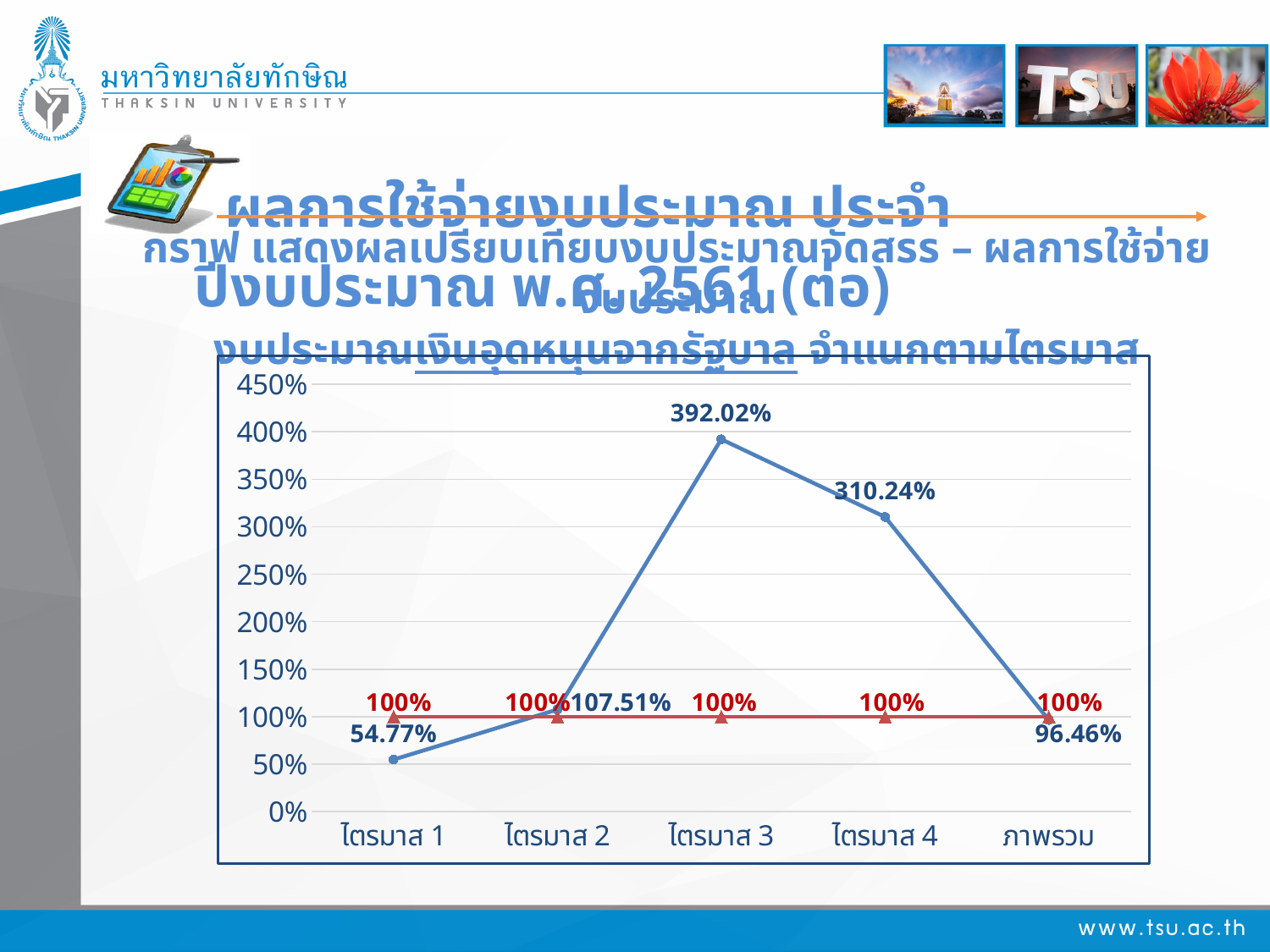
What is the value of the blue line for ไตรมาส 3? 392.02% What is the value of the blue line for ไตรมาส 4? 310.24% What is the value of the blue line for ภาพรวม? 96.46% Which category has the lowest value on the blue line? ไตรมาส 1 What is the difference between the blue line values for ไตรมาส 3 and ไตรมาส 4? 81.78% What kind of chart is shown on the slide? line chart Which is larger, the blue line value for ไตรมาส 2 or for ภาพรวม? ไตรมาส 2 Which category has the highest value on the blue line? ไตรมาส 3 Is the blue line value for ไตรมาส 4 greater or less than 300%? greater How many categories are shown on the x axis of the chart? 5 What is the value of the red line for ไตรมาส 2? 100% What is the value of the blue line for ไตรมาส 1? 54.77%